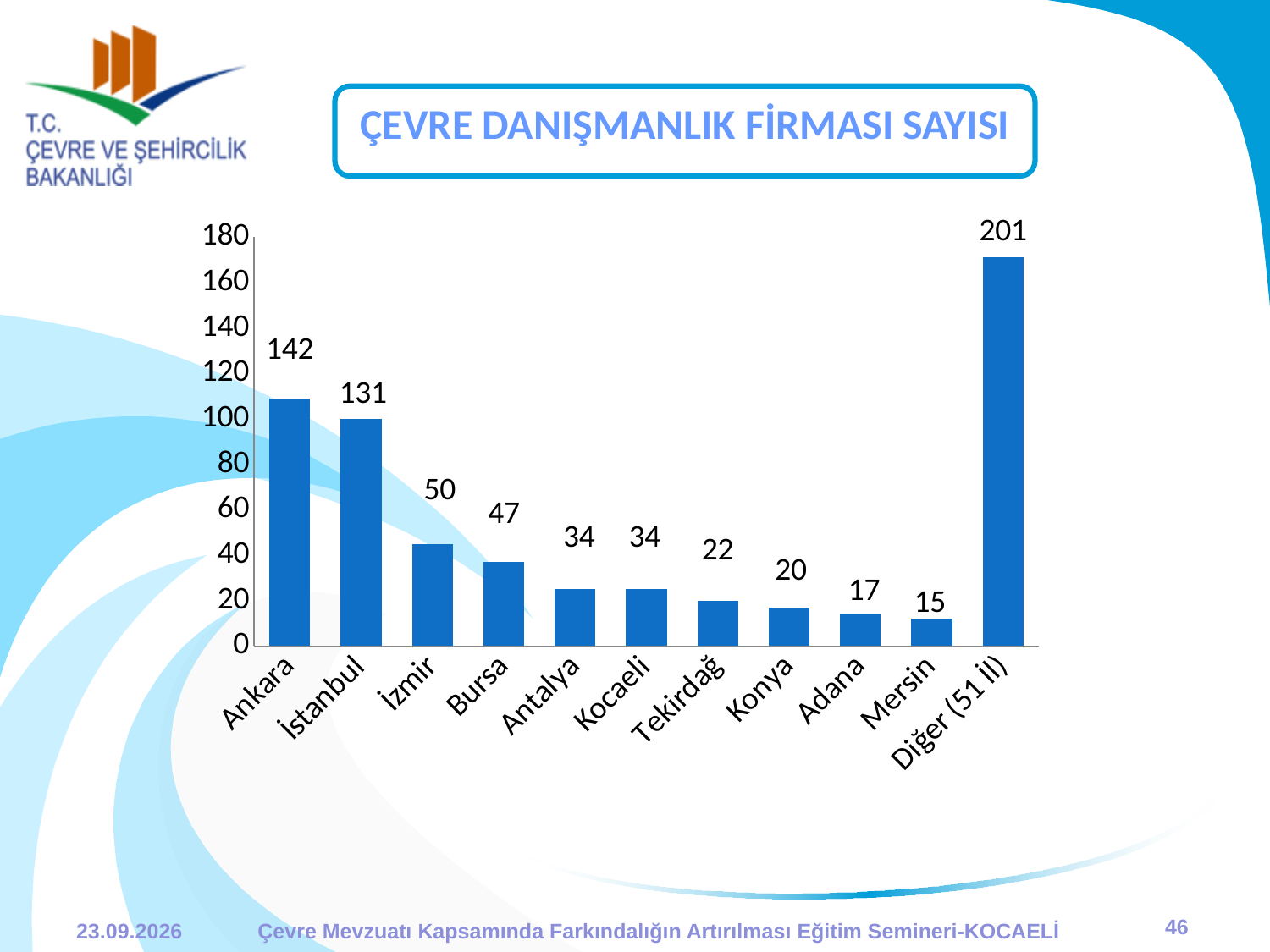
What is the value for Tekirdağ? 22 What is the title of the chart? ÇEVRE DANIŞMANLIK FİRMASI SAYISI What is the value for Ankara? 142 What is the difference between the values for Ankara and İstanbul? 11 Which is larger, the value for Konya or the value for Adana? Konya Which category has the lowest value? Mersin What is the value for İstanbul? 131 How many categories are shown on the x axis? 11 What is the value for Diğer (51 İl)? 201 What is the difference between the values for İzmir and Bursa? 3 What kind of chart is shown on the slide? Bar chart Which category has the highest value? Diğer (51 İl)